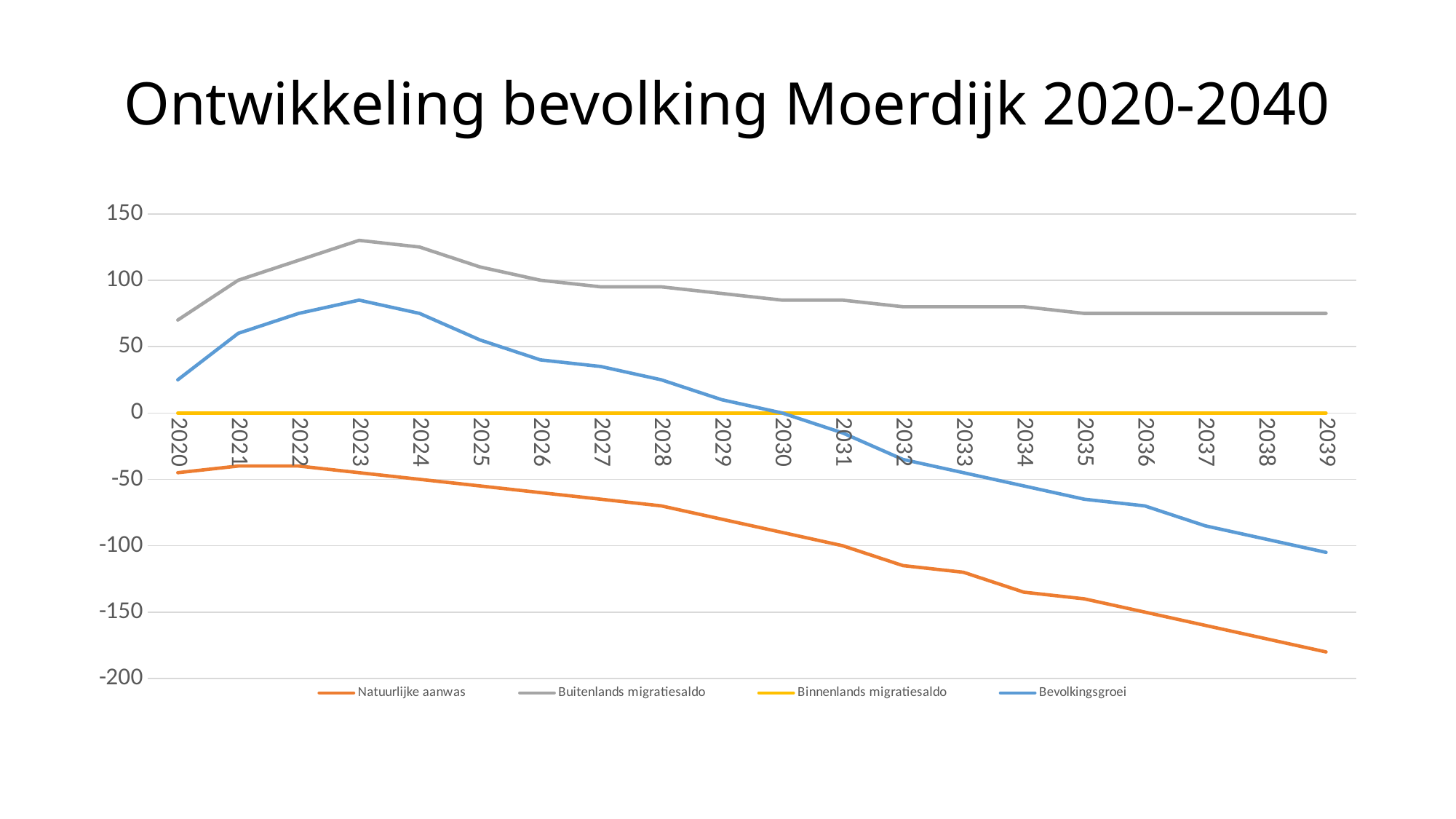
What is the value of Binnenlands migratiesaldo in 2030? 0 Is the value for Buitenlands migratiesaldo in 2023 greater or less than 100? greater In 2020, which is larger: Buitenlands migratiesaldo or Bevolkingsgroei? Buitenlands migratiesaldo How many years are plotted along the x axis? 20 In which year is Bevolkingsgroei at its lowest? 2039 Is the value for Natuurlijke aanwas in 2039 greater or less than -150? less What is the title of the chart? Ontwikkeling bevolking Moerdijk 2020-2040 In which year does Buitenlands migratiesaldo reach its highest value? 2023 What kind of chart is shown on the slide? line chart How many series does the legend list? 4 Is the value for Bevolkingsgroei in 2023 greater or less than 50? greater Does Natuurlijke aanwas rise or fall from 2023 to 2039? fall